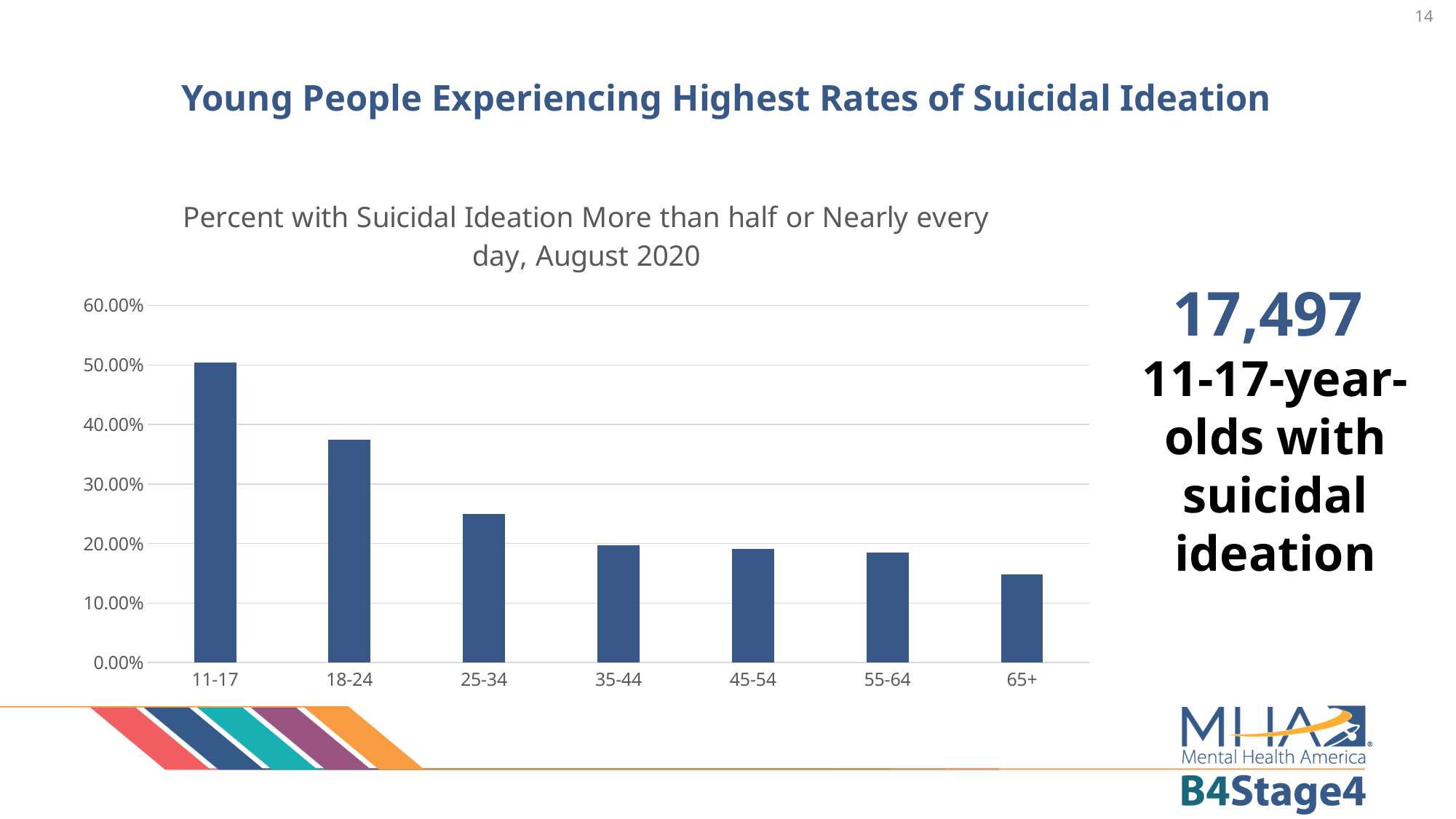
Which age group has the lowest percent with suicidal ideation? 65+ Is the value for 65+ greater or less than 10.00%? greater Do the values rise or fall as the age groups move from 11-17 to 65+ along the x axis? fall Which age group has the highest percent with suicidal ideation? 11-17 Is the value for 25-34 greater or less than 30.00%? less Which age group has a higher value, 25-34 or 65+? 25-34 What kind of chart is shown on the slide? bar chart How many age groups are shown on the x axis of the chart? 7 What is the title of the chart? Percent with Suicidal Ideation More than half or Nearly every day, August 2020 Is the value for 18-24 greater or less than 30.00%? greater Which age group has a higher value, 11-17 or 18-24? 11-17